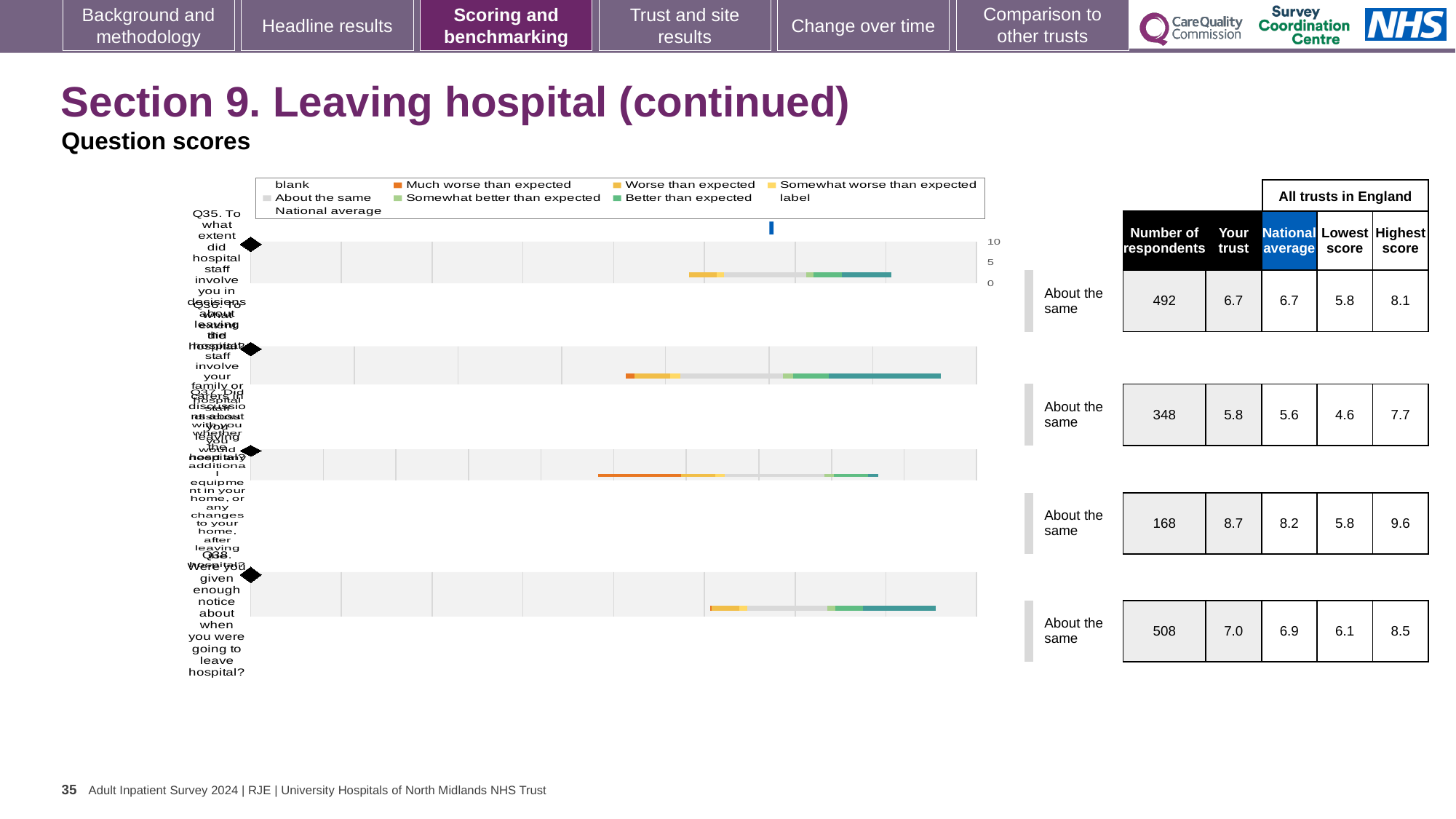
In the legend, what does the dark orange colour represent? Much worse than expected What is the number of respondents for Q35 (involving you in decisions about leaving hospital)? 492 What kind of chart is used to show the question scores on this slide? bar chart Which row has the highest 'Your trust' score? the third question from the top (8.7) How many questions (rows) are plotted in the chart? 4 What is the lowest score across all trusts in England for Q35? 5.8 For Q38, what is the difference between the highest score and the lowest score across all trusts in England? 2.4 What is the 'Your trust' score for Q38 (given enough notice about when you were going to leave hospital)? 7.0 What benchmark category is shown for every question on this slide? About the same For Q38, which is larger: the 'Your trust' score or the national average? Your trust (7.0) What is the national average for the third question from the top? 8.2 Which row has the lowest 'Your trust' score? the second question from the top (5.8)